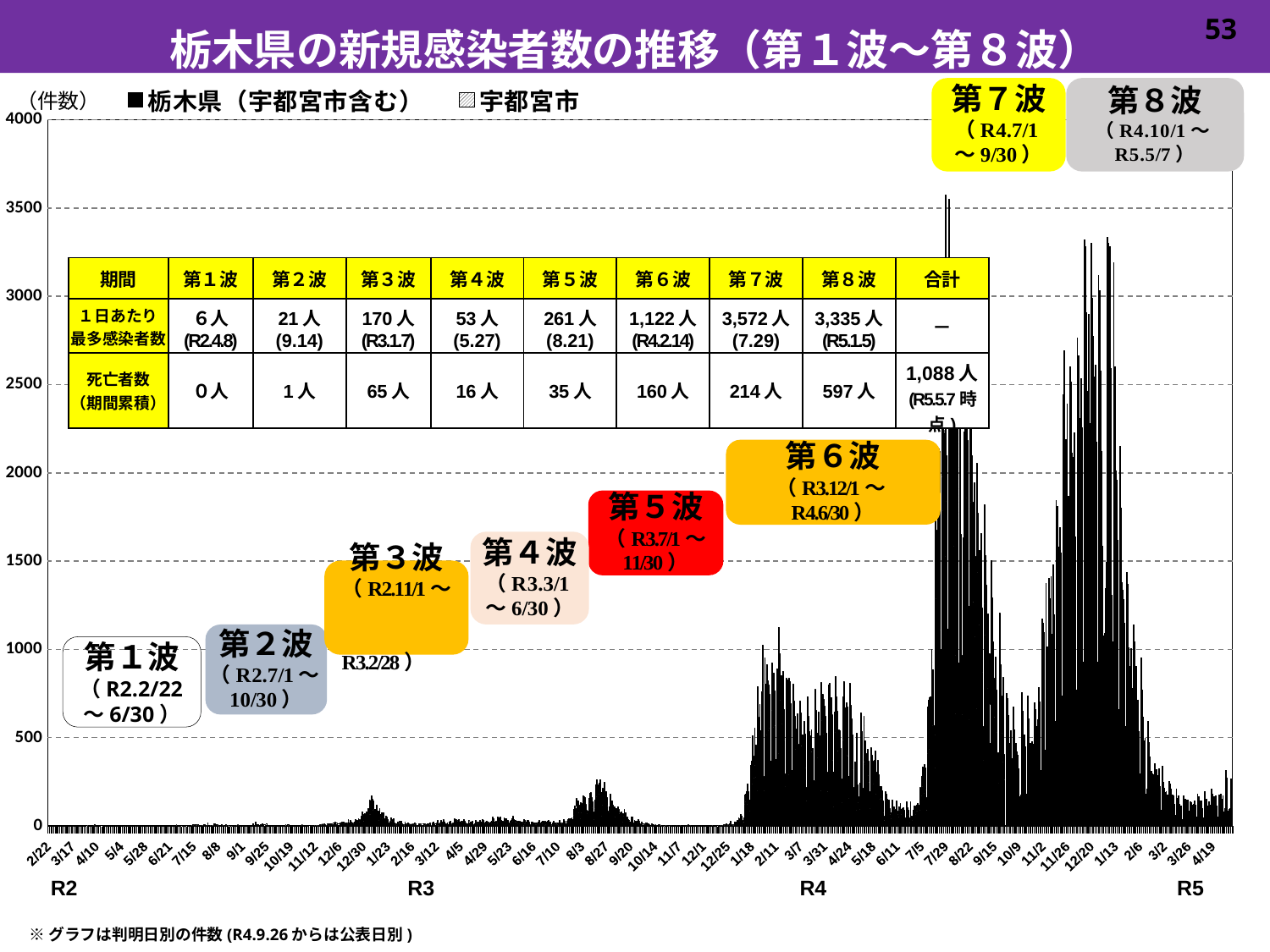
What is the maximum value shown on the vertical axis? 4000 What kind of chart is shown on the slide? bar chart According to the table, what was the highest daily number of new infections in the 7th wave (第７波)? 3,572人 Which wave had more cumulative deaths, the 6th wave or the 8th wave? 第８波 What is the difference between the peak daily infections of the 7th wave and the 8th wave? 237人 Which wave had the lowest peak daily number of new infections? 第１波 What is the title of the chart? 栃木県の新規感染者数の推移（第１波～第８波） How many series does the legend list? 2 According to the table, what was the highest daily number of new infections in the 1st wave (第１波)? 6人 Which wave had the highest peak daily number of new infections? 第７波 What is the total number of deaths shown in the 合計 column of the table? 1,088人 Is the peak daily value in the 7th wave greater or less than 3500? greater